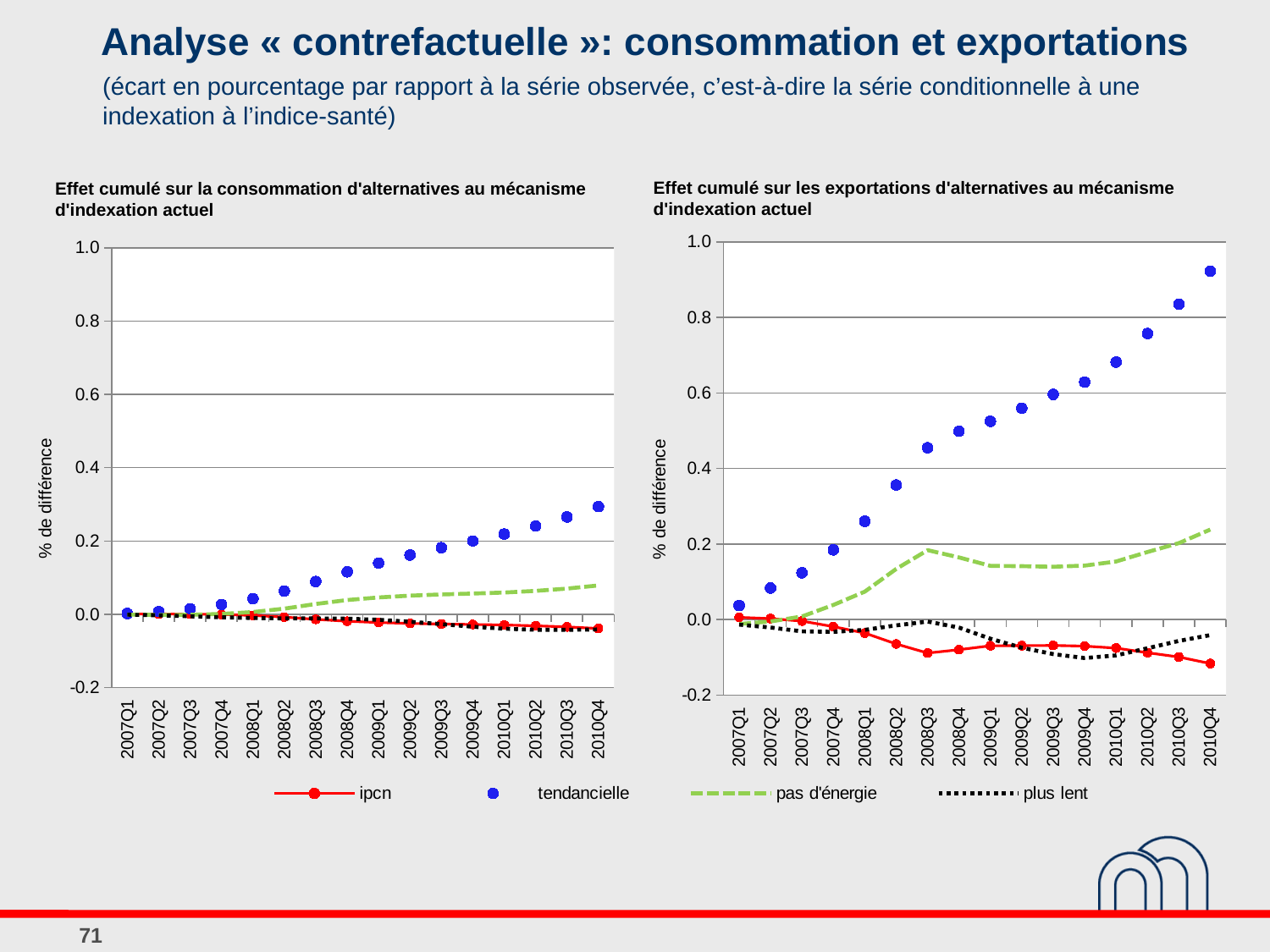
In the right chart, 'Effet cumulé sur les exportations', is the value for tendancielle at 2010Q4 greater or less than 0.8? greater At 2010Q4, is the tendancielle value larger in the left chart (consommation) or the right chart (exportations)? right chart (exportations) In the right chart, 'Effet cumulé sur les exportations', which series has the highest value at 2010Q4? tendancielle What kind of chart is the left chart, 'Effet cumulé sur la consommation d'alternatives au mécanisme d'indexation actuel'? line chart In the left chart, 'Effet cumulé sur la consommation', is the value for pas d'énergie at 2010Q4 greater or less than 0.2? less What is the label on the y axis of both charts? % de différence In the right chart, 'Effet cumulé sur les exportations', which series has the lowest value at 2010Q4? ipcn In the right chart, 'Effet cumulé sur les exportations', does the tendancielle series rise or fall from 2007Q1 to 2010Q4? rise In the left chart, 'Effet cumulé sur la consommation', is the value for tendancielle at 2010Q4 greater or less than 0.2? greater In the right chart, 'Effet cumulé sur les exportations', how many quarters are plotted along the x axis? 16 How many series does the legend list for the charts on the slide? 4